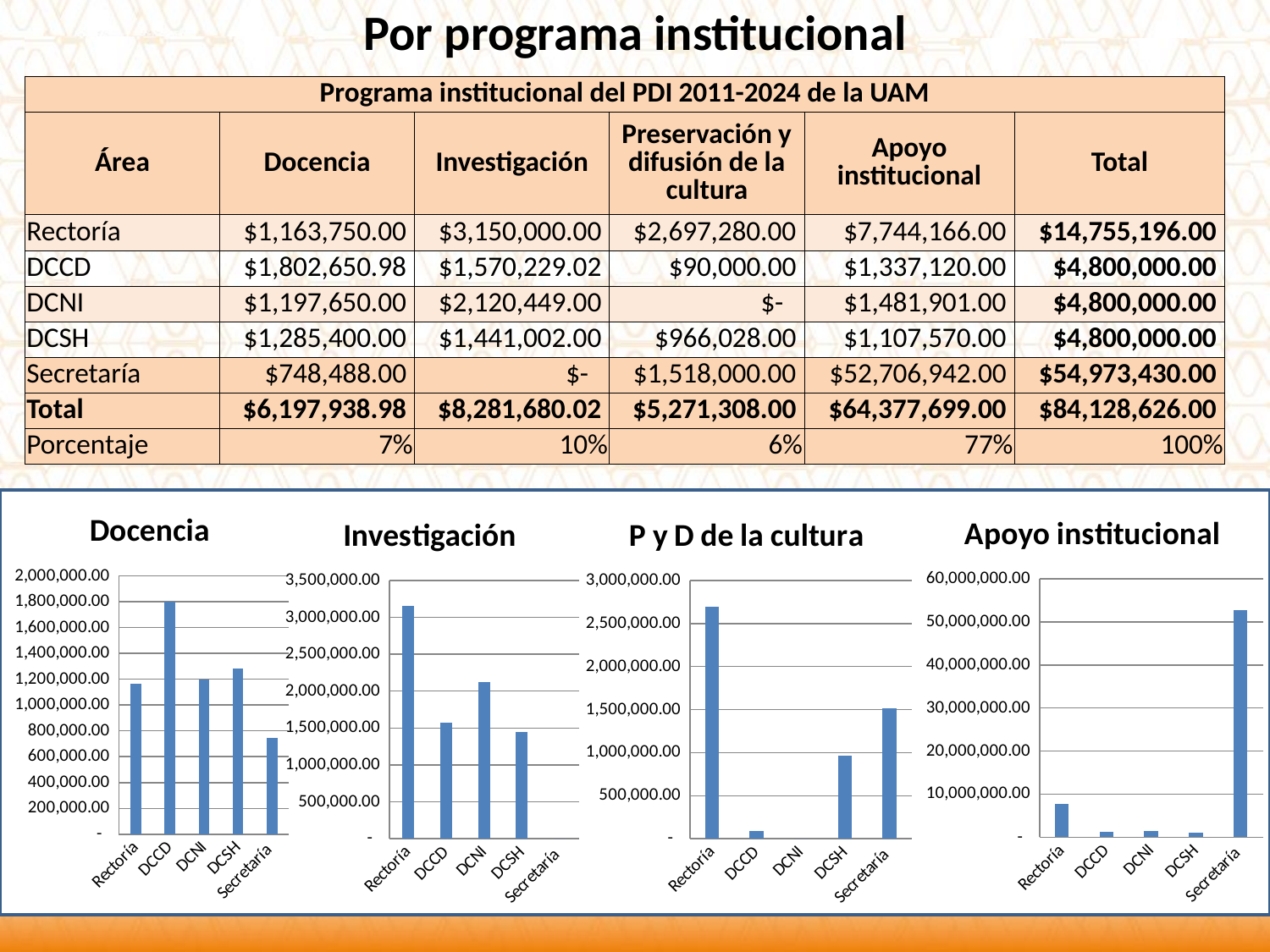
In the Investigación chart, which is larger, the value for DCCD or the value for DCNI? DCNI How many areas are shown on the x axis of the Docencia chart? 5 In the Apoyo institucional chart, is the value for Rectoría greater or less than 10,000,000.00? less In the Investigación chart, which area has the highest bar? Rectoría In the Investigación chart, is the value for DCNI greater or less than 2,000,000.00? greater In the Docencia chart, which area has the highest bar? DCCD In the P y D de la cultura chart, which area has the highest bar? Rectoría In the Docencia chart, is the value for DCCD greater or less than 1,600,000.00? greater In the Docencia chart, which area has the lowest bar? Secretaría What kind of chart is the Apoyo institucional chart? Bar chart